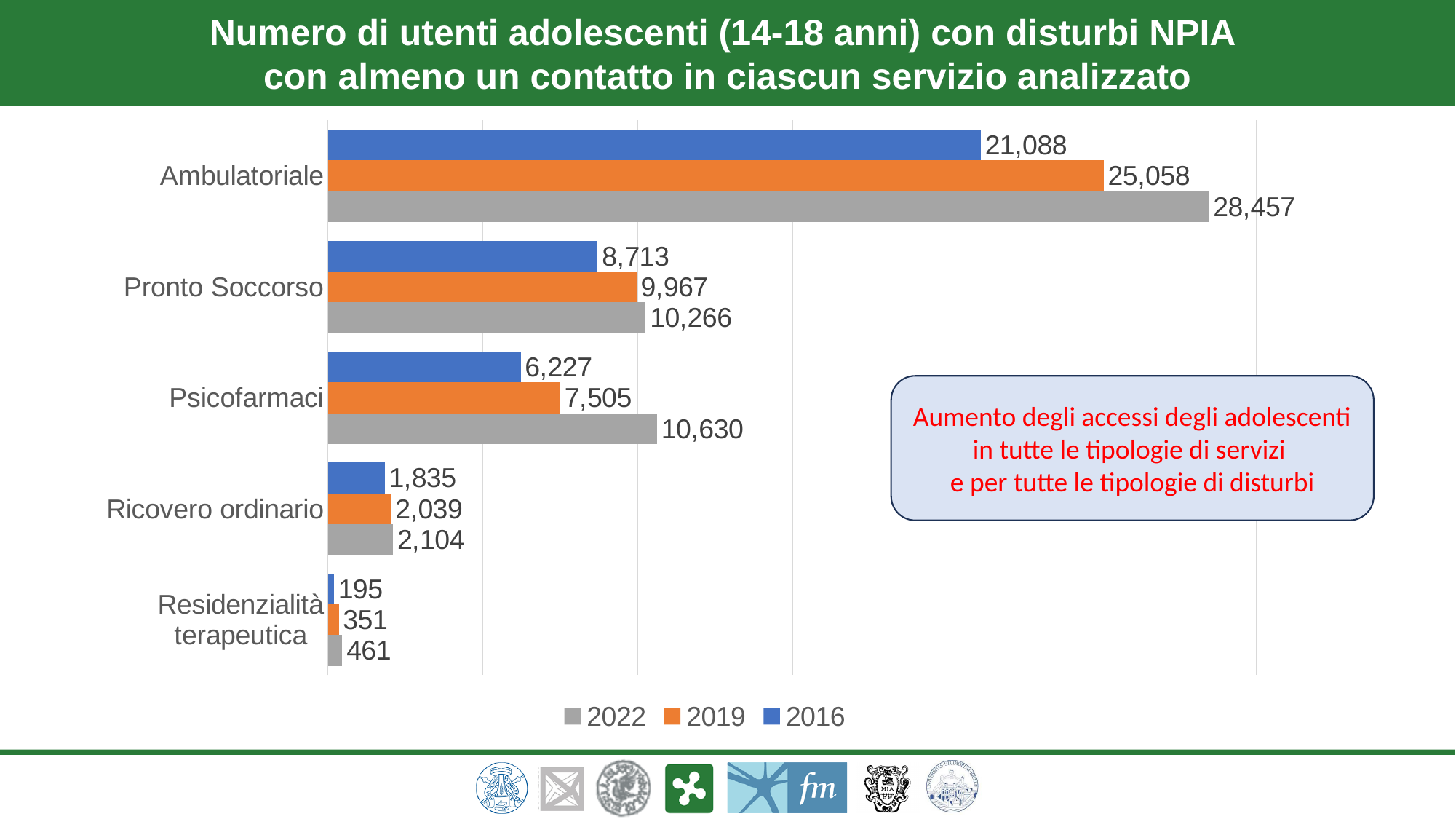
How many categories are shown on the chart? 5 What is the value for Psicofarmaci in 2019? 7,505 Which category has the lowest value in 2016? Residenzialità terapeutica What is the value for Residenzialità terapeutica in 2022? 461 What is the difference between the 2022 and 2019 values for Psicofarmaci? 3,125 Which is larger: the 2022 value for Pronto Soccorso or the 2022 value for Psicofarmaci? Psicofarmaci What is the value for Pronto Soccorso in 2016? 8,713 How many series does the legend list? 3 What kind of chart is shown on the slide? Bar chart What is the value for Ambulatoriale in 2022? 28,457 Which category has the highest value in 2022? Ambulatoriale What is the difference between the 2022 and 2016 values for Ambulatoriale? 7,369